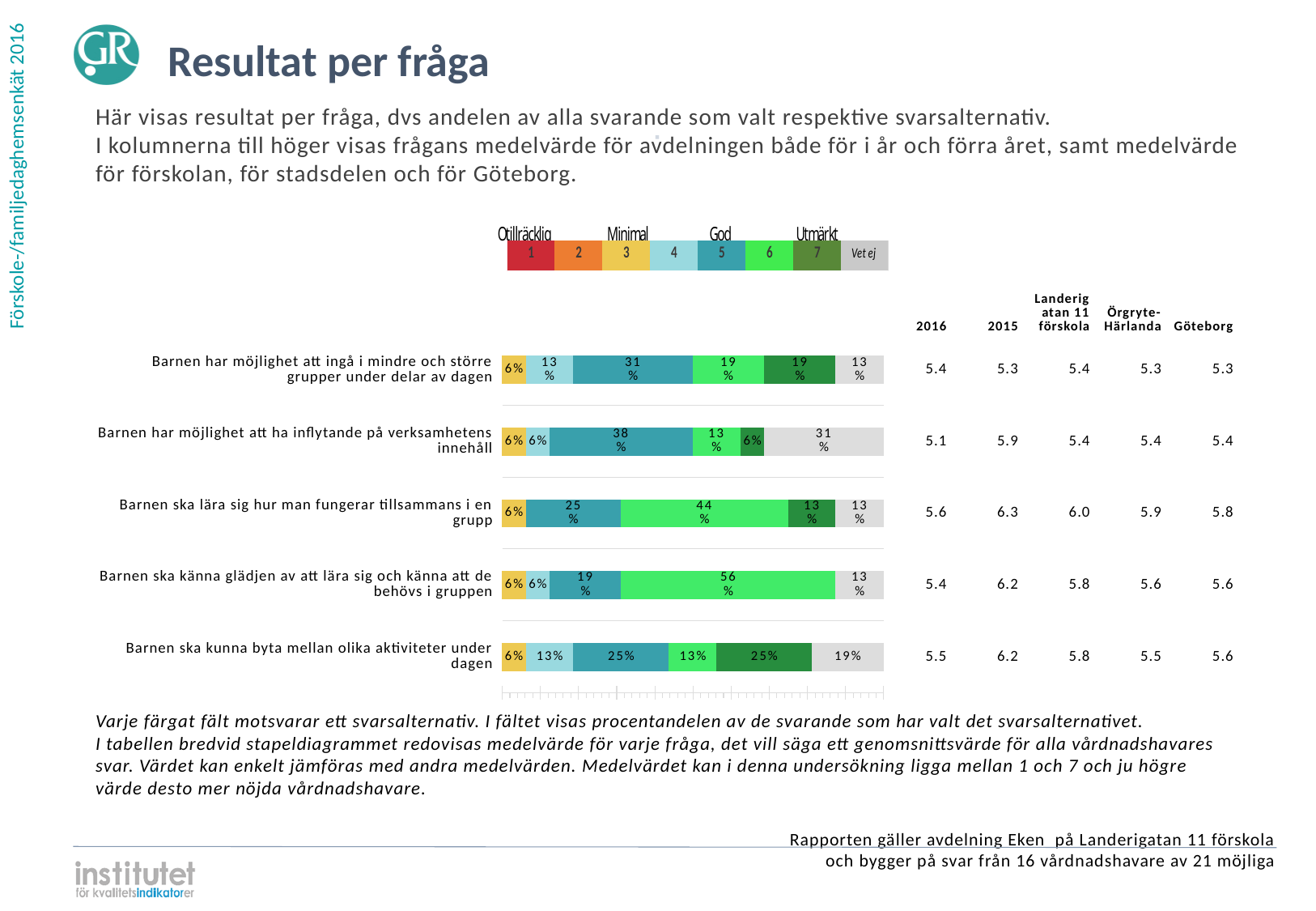
How many response categories does the legend above the chart list? 8 What is the 2016 mean value shown for 'Barnen ska lära sig hur man fungerar tillsammans i en grupp'? 5.6 What kind of chart is used to show the results per question? Stacked bar chart How many questions (categories) are shown in the bar chart? 5 Which is larger: the 'Vet ej' share for 'Barnen har möjlighet att ha inflytande på verksamhetens innehåll' or for 'Barnen ska kunna byta mellan olika aktiviteter under dagen'? Barnen har möjlighet att ha inflytande på verksamhetens innehåll What is the difference between the response 6 share (44%) and the response 5 share (25%) for 'Barnen ska lära sig hur man fungerar tillsammans i en grupp'? 19% What is the largest single segment in the bar for 'Barnen ska känna glädjen av att lära sig och känna att de behövs i gruppen'? 56% What percentage chose response 5 (God) for 'Barnen har möjlighet att ingå i mindre och större grupper under delar av dagen'? 31% What label does the legend give to response values 1 and 2? Otillräcklig What percentage chose 'Vet ej' for 'Barnen ska kunna byta mellan olika aktiviteter under dagen'? 19% What percentage chose response 6 for 'Barnen ska lära sig hur man fungerar tillsammans i en grupp'? 44% What percentage of respondents chose 'Vet ej' for 'Barnen har möjlighet att ha inflytande på verksamhetens innehåll'? 31%